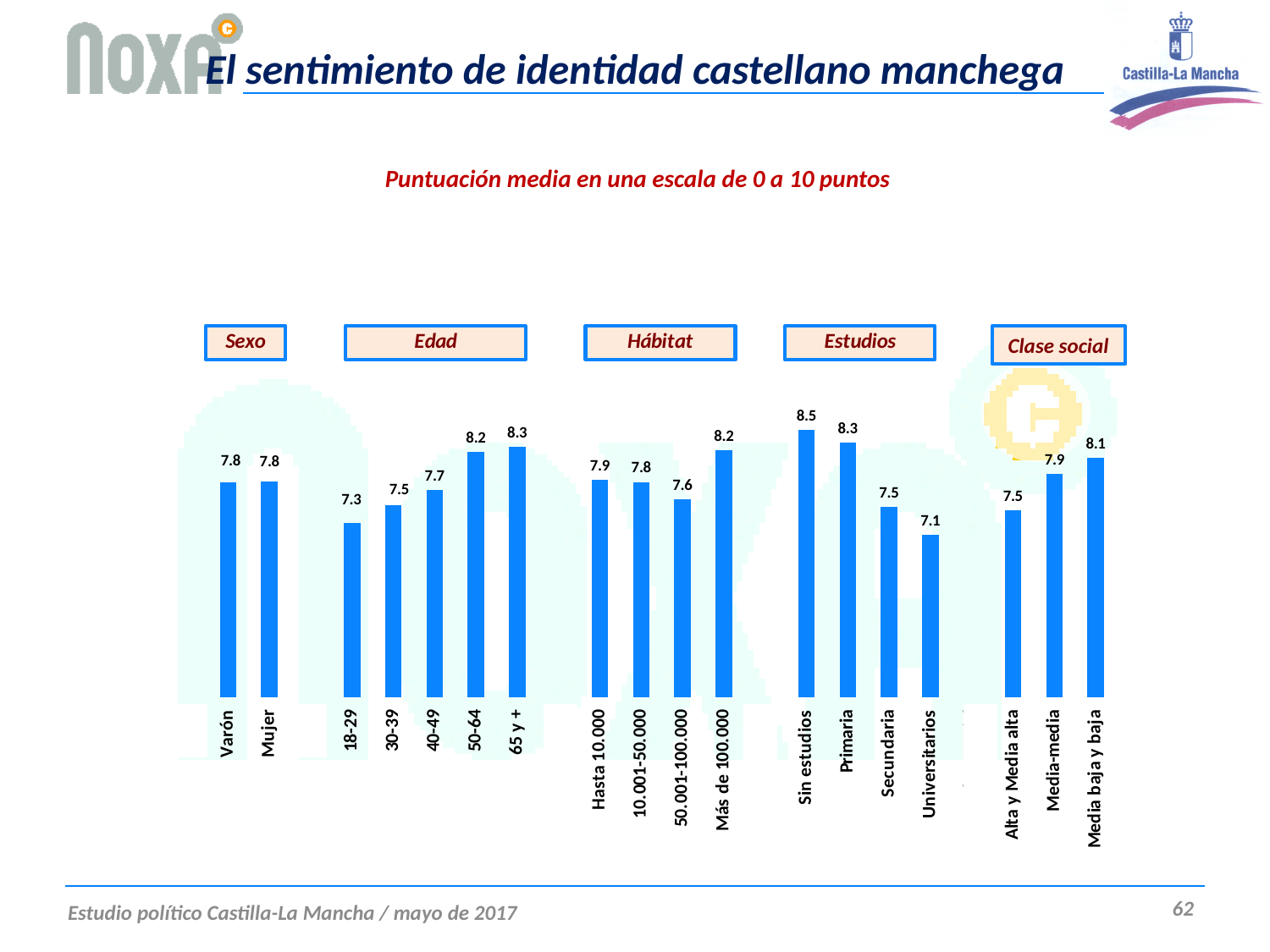
In the Hábitat chart, which category has the lowest value? 50.001-100.000 In the Clase social chart, what is the value for Media baja y baja? 8.1 In the Edad chart, what is the value for the 18-29 group? 7.3 In the Estudios chart, which category has the lowest value? Universitarios In the Clase social chart, which is larger, Media-media or Alta y Media alta? Media-media In the Estudios chart, what is the difference between Sin estudios and Universitarios? 1.4 In the Sexo chart, what is the value for Mujer? 7.8 How many categories are shown in the Hábitat chart? 4 In the Edad chart, which age group has the highest value? 65 y + In the Hábitat chart, what is the value for Más de 100.000? 8.2 In the Edad chart, do the values rise or fall as age increases from 18-29 to 65 y +? rise What kind of chart is used in the Edad section? bar chart